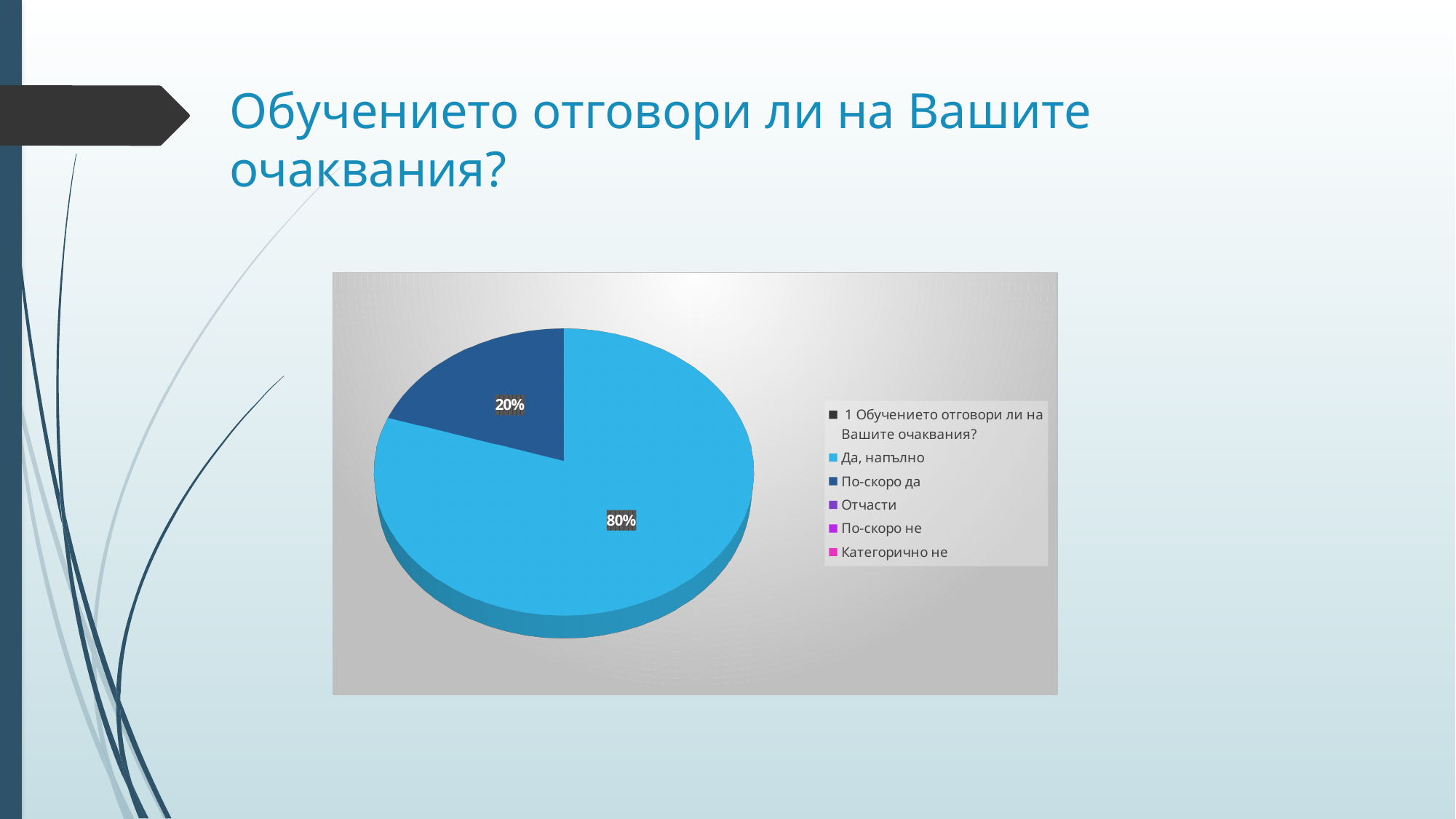
What kind of chart is shown on the slide? Pie chart What share of the pie does "Да, напълно" represent? 80% What is the difference in percentage points between the "Да, напълно" slice and the "По-скоро да" slice? 60 percentage points Which of the two labelled slices is the smaller one? По-скоро да What is the title of the slide? Обучението отговори ли на Вашите очаквания? Which category has the largest slice of the pie? Да, напълно Which is larger: the slice for "Да, напълно" or the slice for "По-скоро да"? Да, напълно What share of the pie does "По-скоро да" represent? 20% Is the share for "Да, напълно" greater or less than 50%? greater How many slices with data labels are visible in the pie? 2 How many entries does the chart legend list? 6 What colour is the slice labelled 80%? Light blue